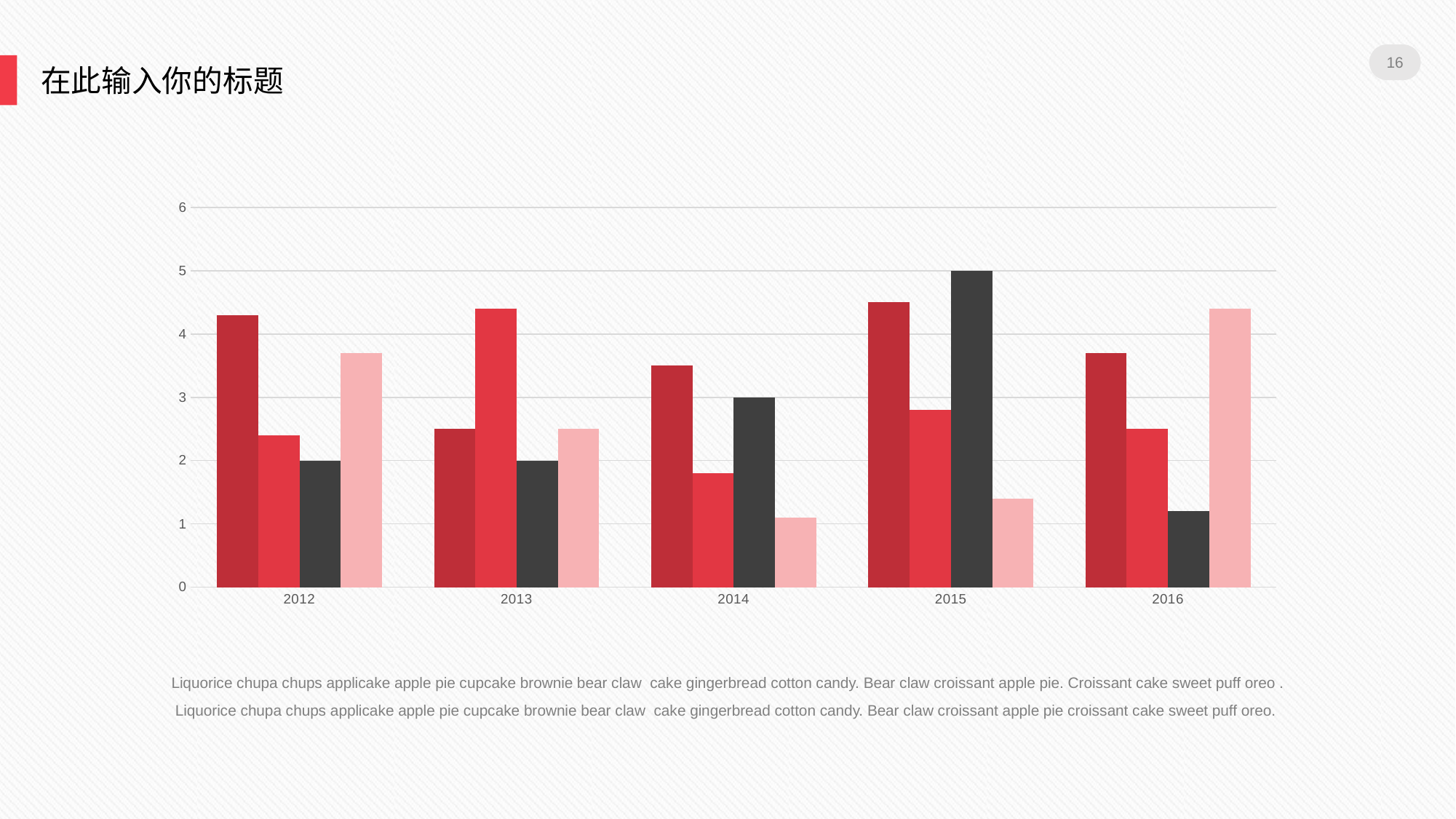
What is the value of the dark gray bar for 2012? 2 For 2016, which is taller: the dark red bar or the light pink bar? light pink bar How many years are shown on the x axis of the chart? 5 Is the value of the dark gray bar for 2016 greater or less than 2? less In which year is the dark gray bar the tallest? 2015 Is the value of the dark red bar for 2012 greater or less than 4? greater What is the value of the dark gray bar for 2015? 5 What kind of chart is shown on the slide? bar chart How many bars are plotted for each year in the chart? 4 Is the value of the light pink bar for 2014 greater or less than 2? less In which year is the light pink bar the shortest? 2014 What is the value of the dark gray bar for 2014? 3